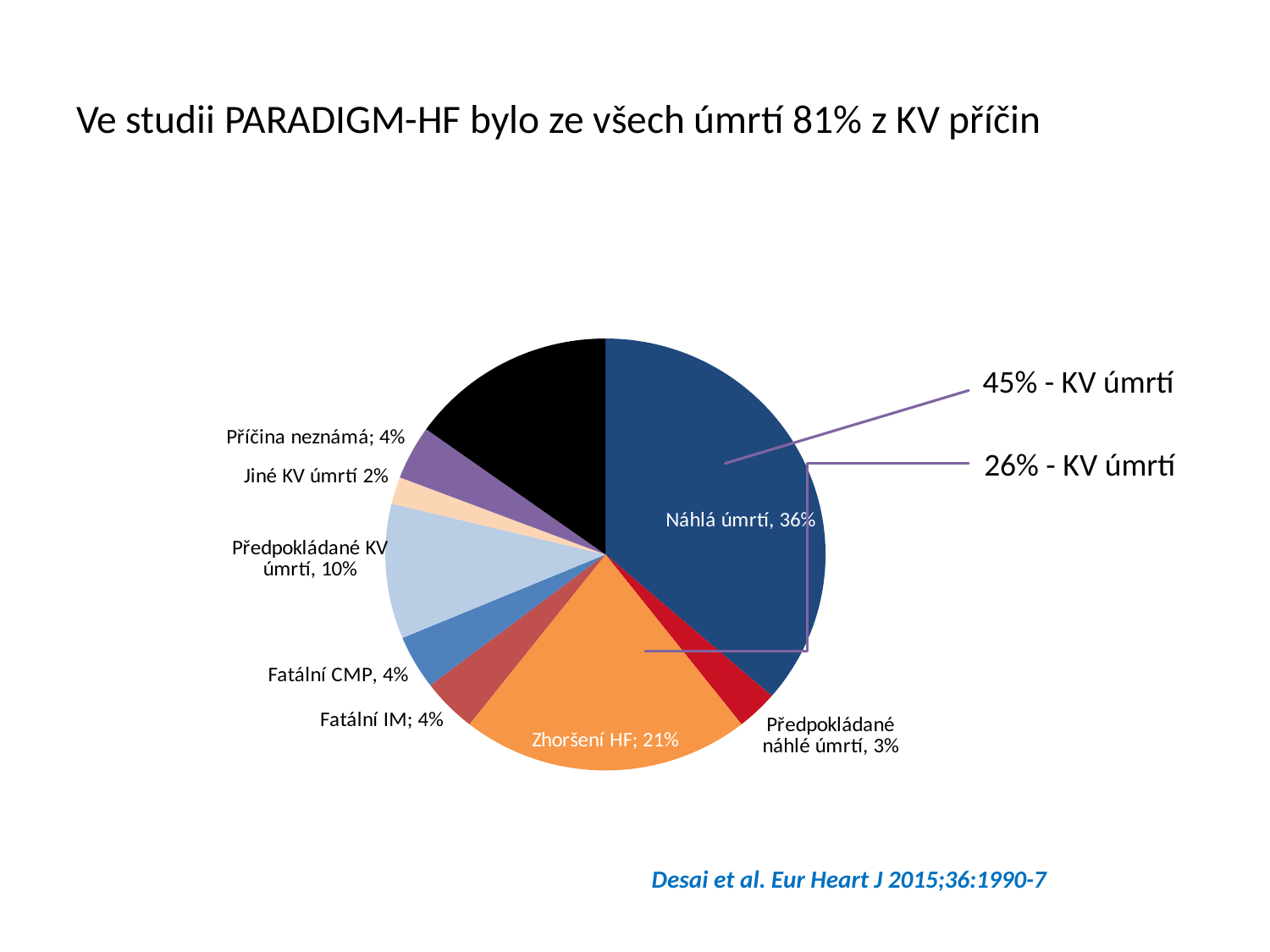
Which is larger, the share for 'Předpokládané KV úmrtí' or the share for 'Fatální IM'? Předpokládané KV úmrtí What percentage is shown for 'Předpokládané náhlé úmrtí'? 3% What percentage is shown for the 'Náhlá úmrtí' slice? 36% Which labelled slice has the largest share of the pie? Náhlá úmrtí What kind of chart is shown on the slide? pie chart What is the difference in percentage points between 'Náhlá úmrtí' and 'Zhoršení HF'? 15 What percentage is shown for the 'Zhoršení HF' slice? 21% What percentage is shown for 'Jiné KV úmrtí'? 2% Which labelled slice has the smallest share of the pie? Jiné KV úmrtí According to the annotation on the right, what share of KV deaths does the 'Náhlá úmrtí' slice represent? 45% - KV úmrtí What is the combined share of 'Fatální CMP' and 'Fatální IM'? 8% What percentage is shown for 'Předpokládané KV úmrtí'? 10%